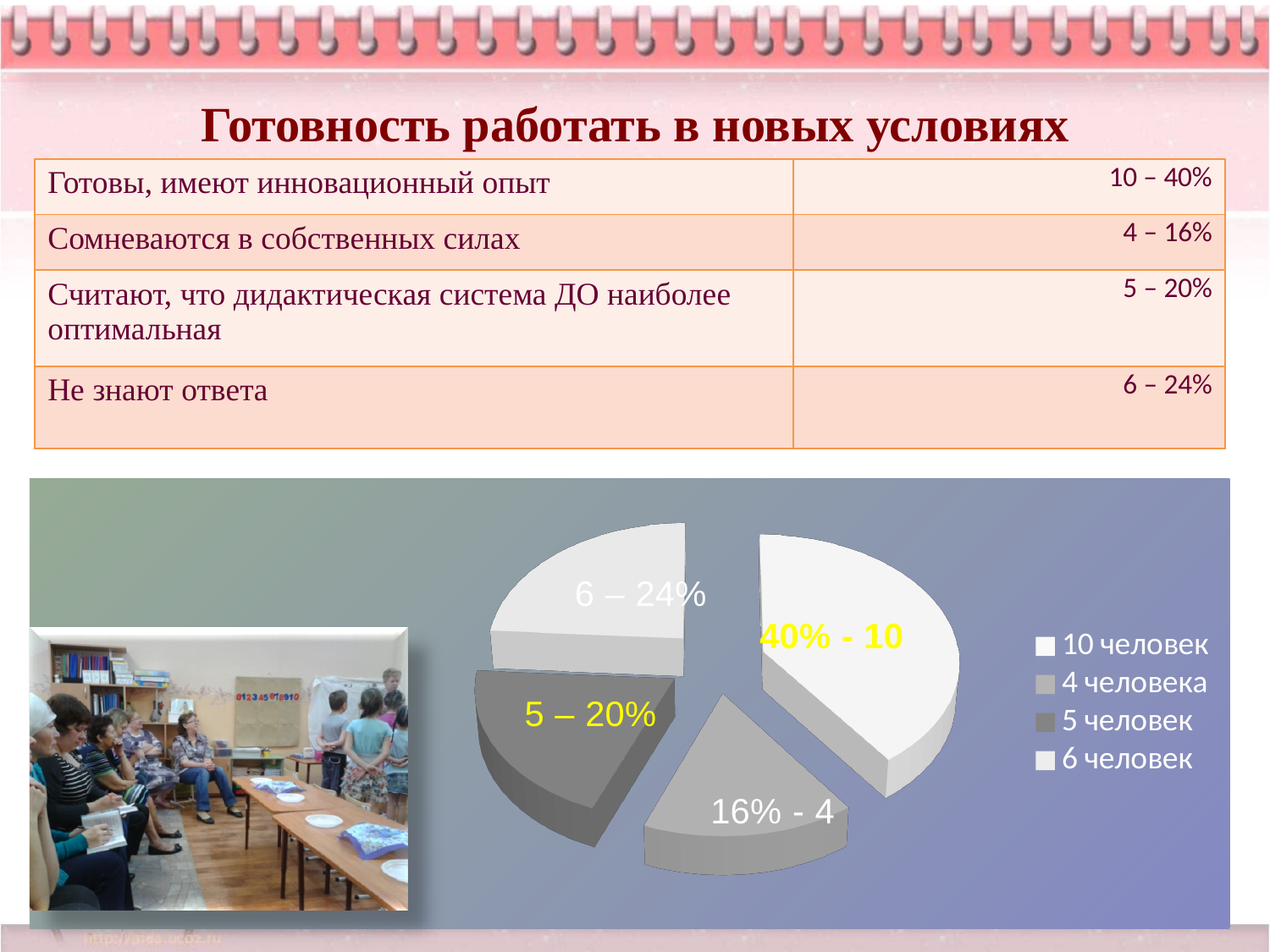
What is the difference in percentage points between the largest slice (40%) and the smallest slice (16%)? 24% What kind of chart is shown on the slide? pie chart How many entries does the legend of the pie chart list? 4 Which legend entry corresponds to the smallest slice of the pie chart? 4 человека What share of the pie does the slice for 5 человек represent? 20% What share of the pie does the slice for 4 человека represent? 16% What share of the pie does the slice for 6 человек represent? 24% Which legend entry corresponds to the largest slice of the pie chart? 10 человек What is the total number of people across all four slices of the pie chart? 25 How many slices does the pie chart have? 4 Which slice is larger: the one for 5 человек or the one for 6 человек? 6 человек